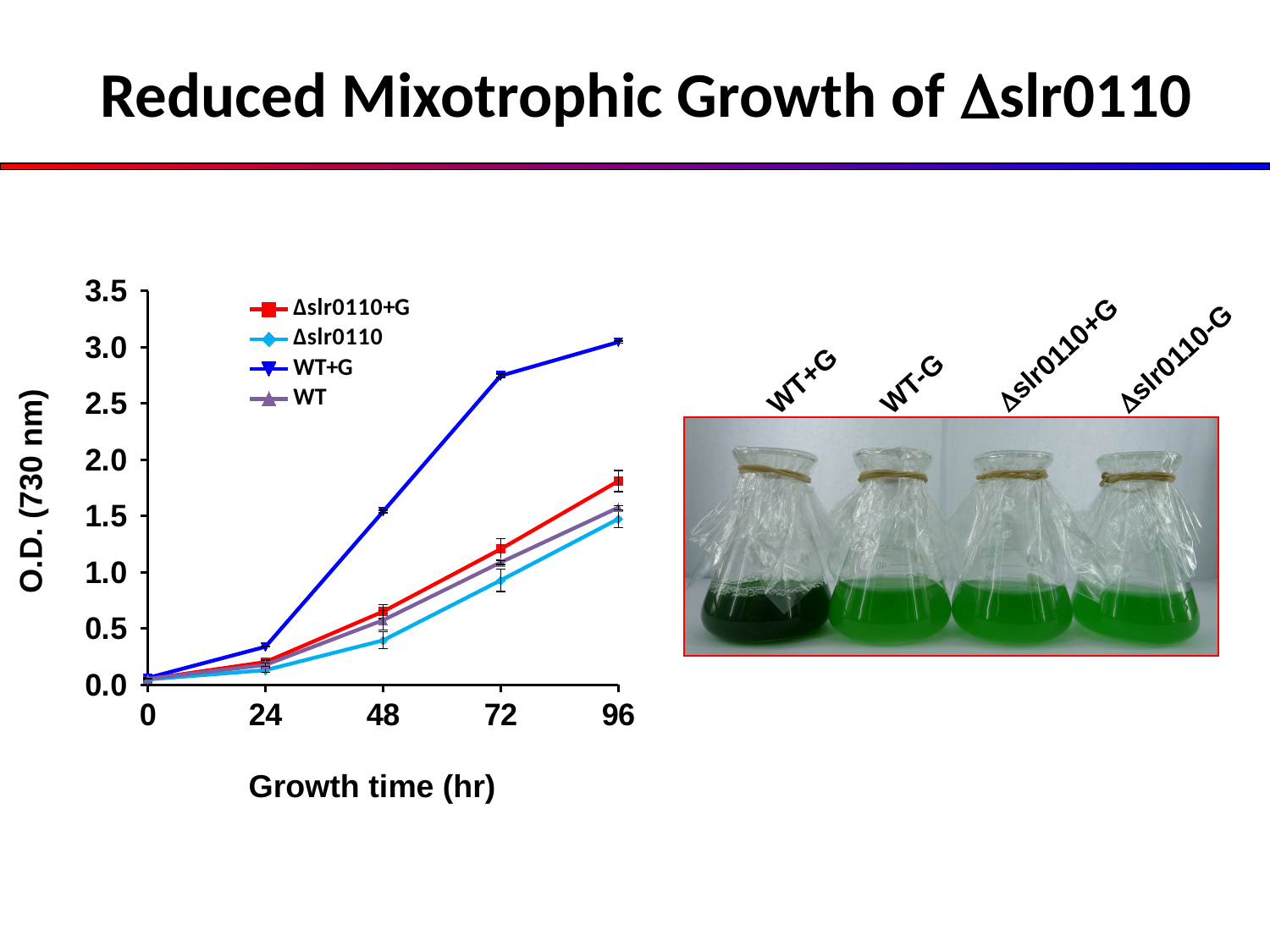
Is the value for WT+G at 48 hr greater or less than 1.0? greater Do the O.D. values for WT+G rise or fall as growth time increases? rise Is the value for WT+G at 72 hr greater or less than 2.5? greater At 72 hr, which series has the larger O.D., WT+G or WT? WT+G Which series has the lowest O.D. at 72 hr? Δslr0110 How many growth time points are plotted along the x axis? 5 Is the value for Δslr0110 at 48 hr greater or less than 0.5? less How many series does the chart's legend list? 4 Which series has the highest O.D. at 96 hr? WT+G What is the label of the chart's y axis? O.D. (730 nm) What kind of chart is shown on the slide? line chart